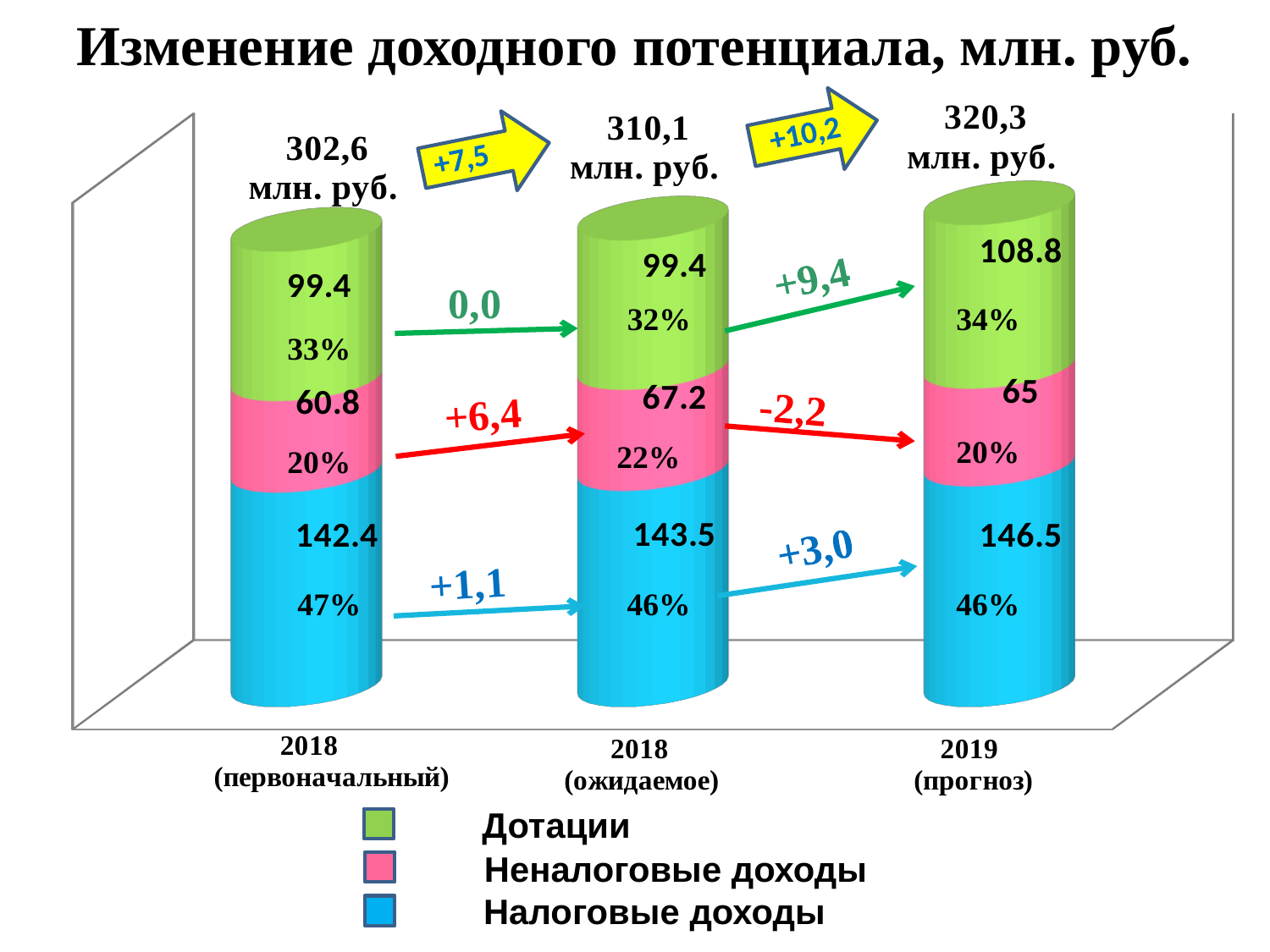
What is the difference in Налоговые доходы between 2019 (прогноз) and 2018 (ожидаемое)? 3.0 What is the total of the stacked bar for 2019 (прогноз)? 320,3 млн. руб. What is the value of Неналоговые доходы for 2018 (ожидаемое)? 67.2 Which is larger: Неналоговые доходы in 2018 (ожидаемое) or in 2019 (прогноз)? 2018 (ожидаемое) What is the value of Налоговые доходы for 2018 (первоначальный)? 142.4 What is the total of the stacked bar for 2018 (первоначальный)? 302,6 млн. руб. What kind of chart is shown on the slide? Stacked bar chart What share of the total do Дотации make up in 2018 (ожидаемое)? 32% What is the value of Дотации for 2019 (прогноз)? 108.8 How many series does the legend list? 3 Which category has the highest value for Дотации? 2019 (прогноз) Which category has the lowest value for Налоговые доходы? 2018 (первоначальный)